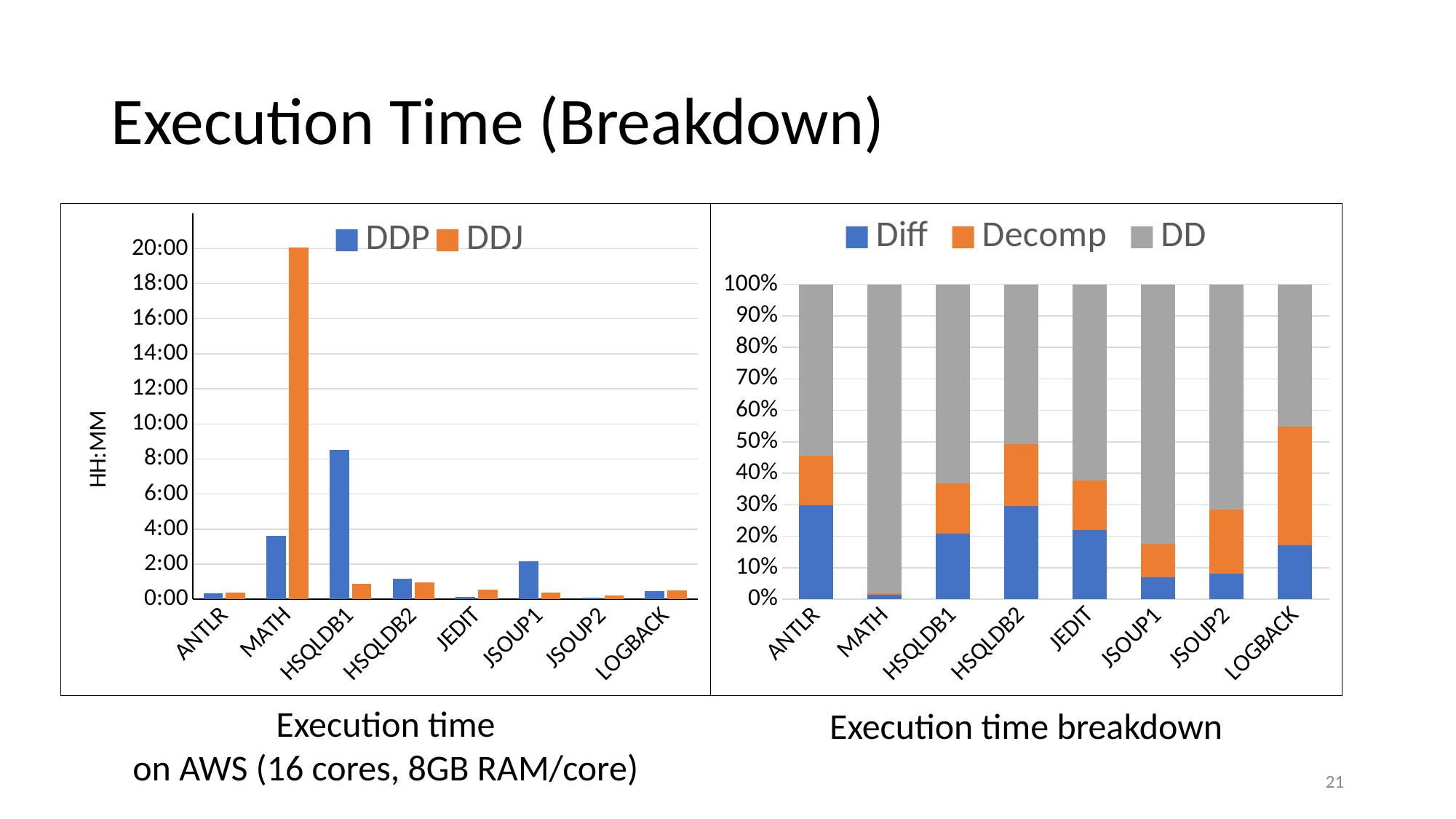
How many series does the legend of the left chart, 'Execution time on AWS', list? 2 What kind of chart is the left chart, 'Execution time on AWS (16 cores, 8GB RAM/core)'? bar chart In the left chart, 'Execution time on AWS', which category has the highest DDP value? HSQLDB1 In the right chart, 'Execution time breakdown', is the Diff share for ANTLR greater or less than 20%? greater In the left chart, 'Execution time on AWS', which is larger for JSOUP1, DDP or DDJ? DDP What are the legend entries of the right chart, 'Execution time breakdown'? Diff, Decomp, DD In the right chart, 'Execution time breakdown', which category has the largest DD share? MATH How many series does the legend of the right chart, 'Execution time breakdown', list? 3 How many categories are shown on the x axis of the left chart, 'Execution time on AWS'? 8 In the left chart, 'Execution time on AWS', is the DDJ value for MATH greater or less than 18:00? greater In the left chart, 'Execution time on AWS', is the DDP value for HSQLDB1 greater or less than 6:00? greater In the left chart, 'Execution time on AWS', which category has the highest DDJ value? MATH